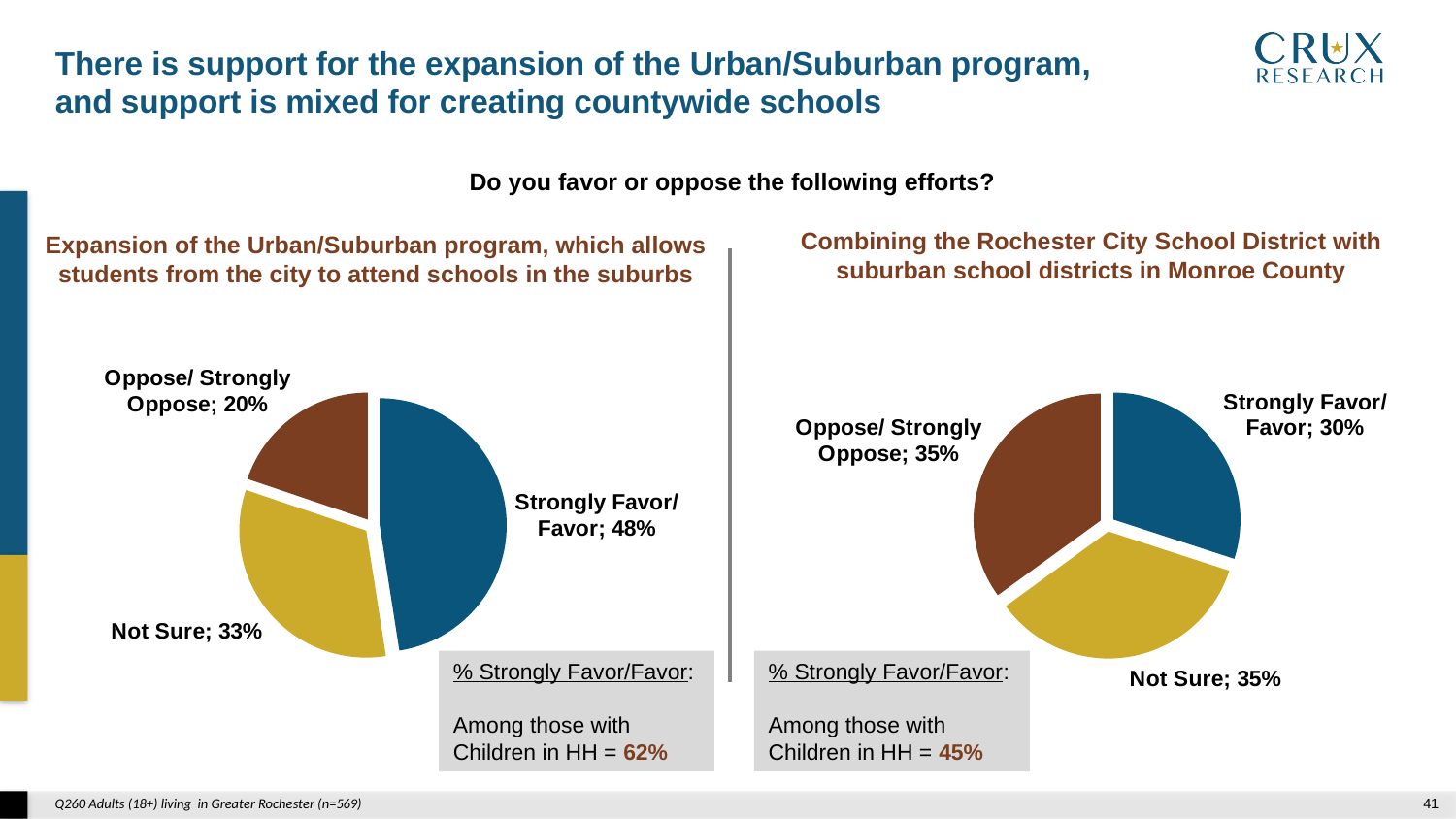
In the left pie chart (Expansion of the Urban/Suburban program), what is the difference in percentage points between Strongly Favor/Favor and Oppose/Strongly Oppose? 28 percentage points In the right pie chart (Combining the Rochester City School District with suburban school districts), what share of respondents answered Not Sure? 35% Which chart shows a larger Strongly Favor/Favor share: the left pie (Expansion of the Urban/Suburban program) or the right pie (Combining the Rochester City School District with suburban school districts)? The left pie (Expansion of the Urban/Suburban program) In the left pie chart (Expansion of the Urban/Suburban program), what share of respondents answered Oppose/Strongly Oppose? 20% In the left pie chart (Expansion of the Urban/Suburban program), which response category has the largest share? Strongly Favor/Favor In the right pie chart (Combining the Rochester City School District with suburban school districts), what share of respondents answered Strongly Favor/Favor? 30% In the left pie chart (Expansion of the Urban/Suburban program), what share of respondents answered Not Sure? 33% What type of chart is used on this slide to show the favor/oppose results? Pie chart How many slices does the right pie chart (Combining the Rochester City School District with suburban school districts) have? 3 In the left pie chart (Expansion of the Urban/Suburban program), which response category has the smallest share? Oppose/Strongly Oppose In the left pie chart (Expansion of the Urban/Suburban program), what share of respondents answered Strongly Favor/Favor? 48% In the right pie chart (Combining the Rochester City School District with suburban school districts), which response category has the smallest share? Strongly Favor/Favor